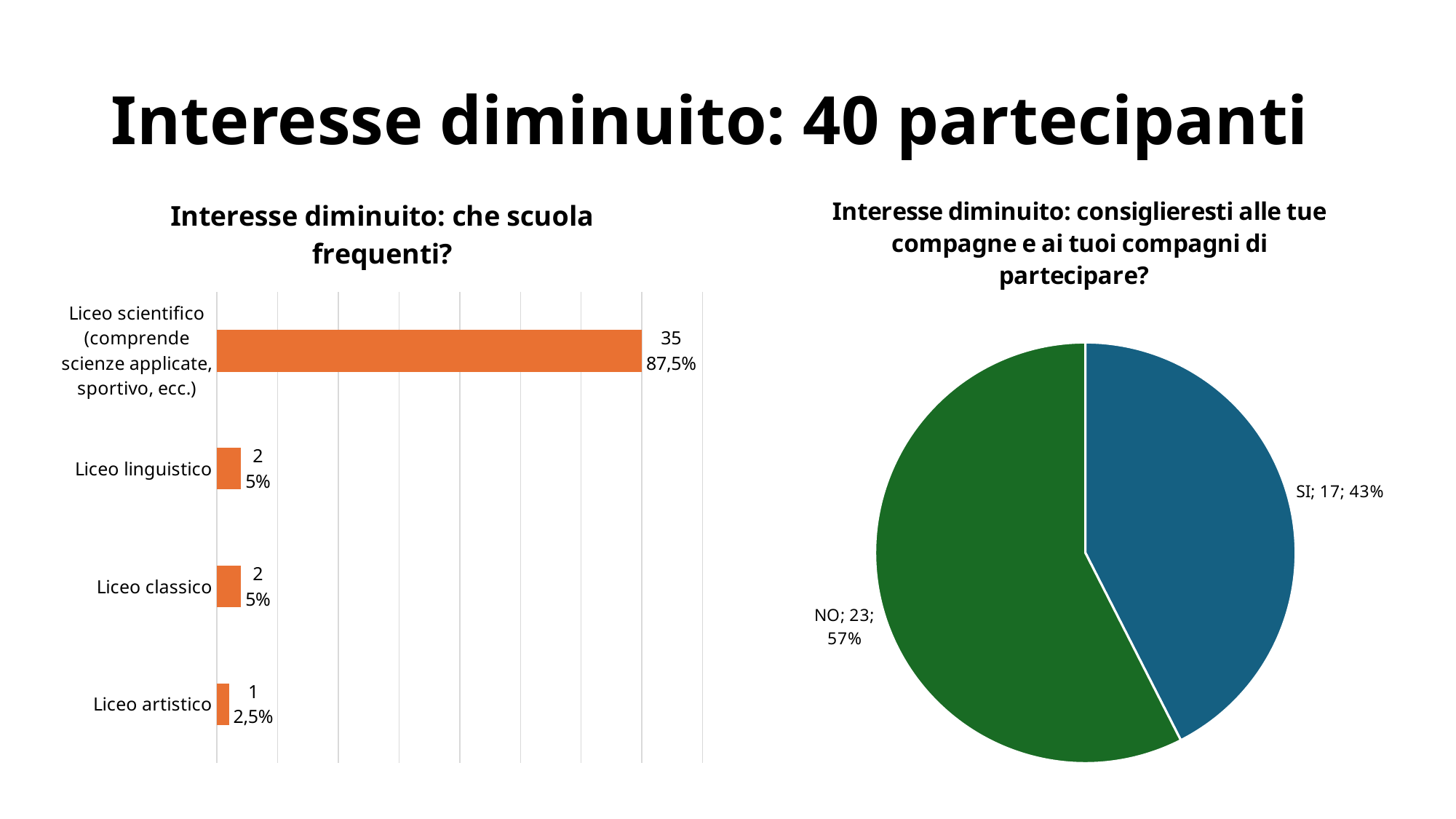
In the pie chart on the right, which answer is larger, SI or NO? NO In the pie chart on the right, what is the difference between the NO and SI counts? 6 In the pie chart on the right, how many participants answered NO? 23 In the chart 'Interesse diminuito: che scuola frequenti?', which school has the highest value? Liceo scientifico What type of chart is the one on the right of the slide? Pie chart What type of chart is 'Interesse diminuito: che scuola frequenti?'? Bar chart In the chart 'Interesse diminuito: che scuola frequenti?', which school has the lowest value? Liceo artistico In the pie chart on the right, what share of the pie does SI represent? 43% In the chart 'Interesse diminuito: che scuola frequenti?', how many school categories are shown? 4 In the chart 'Interesse diminuito: che scuola frequenti?', what is the difference between the values for Liceo scientifico and Liceo linguistico? 33 In the chart 'Interesse diminuito: che scuola frequenti?', what percentage is shown for Liceo artistico? 2,5% In the chart 'Interesse diminuito: che scuola frequenti?', how many participants attend Liceo scientifico? 35